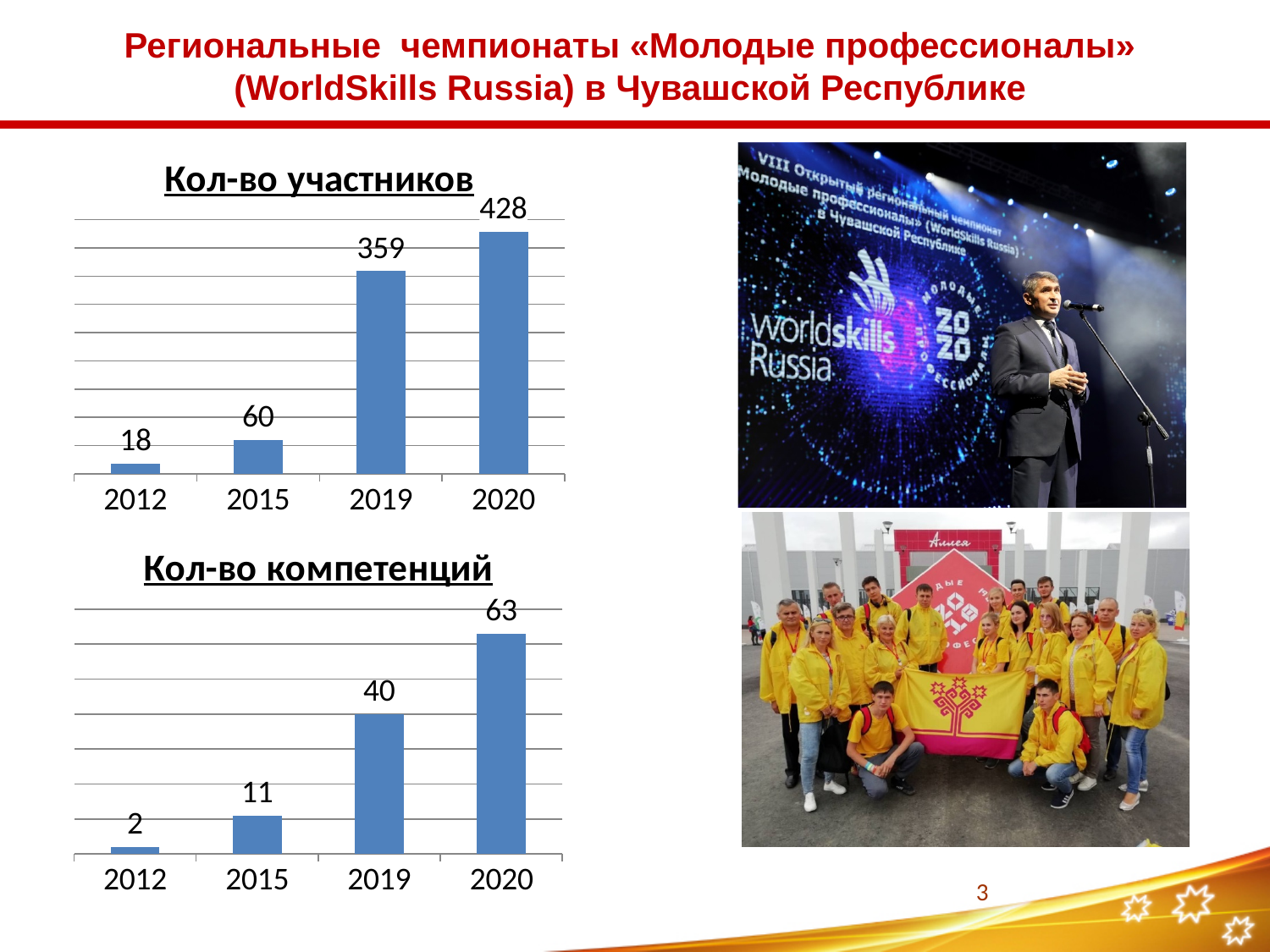
What is the title of the upper chart on the slide? Кол-во участников What kind of chart is the 'Кол-во компетенций' chart? bar chart In the 'Кол-во участников' chart, what is the difference between the values for 2020 and 2019? 69 In the 'Кол-во компетенций' chart, what is the value for 2015? 11 In the 'Кол-во участников' chart, how many years are shown on the x axis? 4 In the 'Кол-во участников' chart, which year has the lowest value? 2012 In the 'Кол-во участников' chart, which year has the highest value? 2020 In the 'Кол-во компетенций' chart, what is the difference between the values for 2019 and 2015? 29 In the 'Кол-во компетенций' chart, which is larger, the value for 2019 or the value for 2015? 2019 In the 'Кол-во участников' chart, what is the value for 2019? 359 In the 'Кол-во компетенций' chart, what is the value for 2020? 63 In the 'Кол-во участников' chart, do the values rise or fall from 2012 to 2020? rise